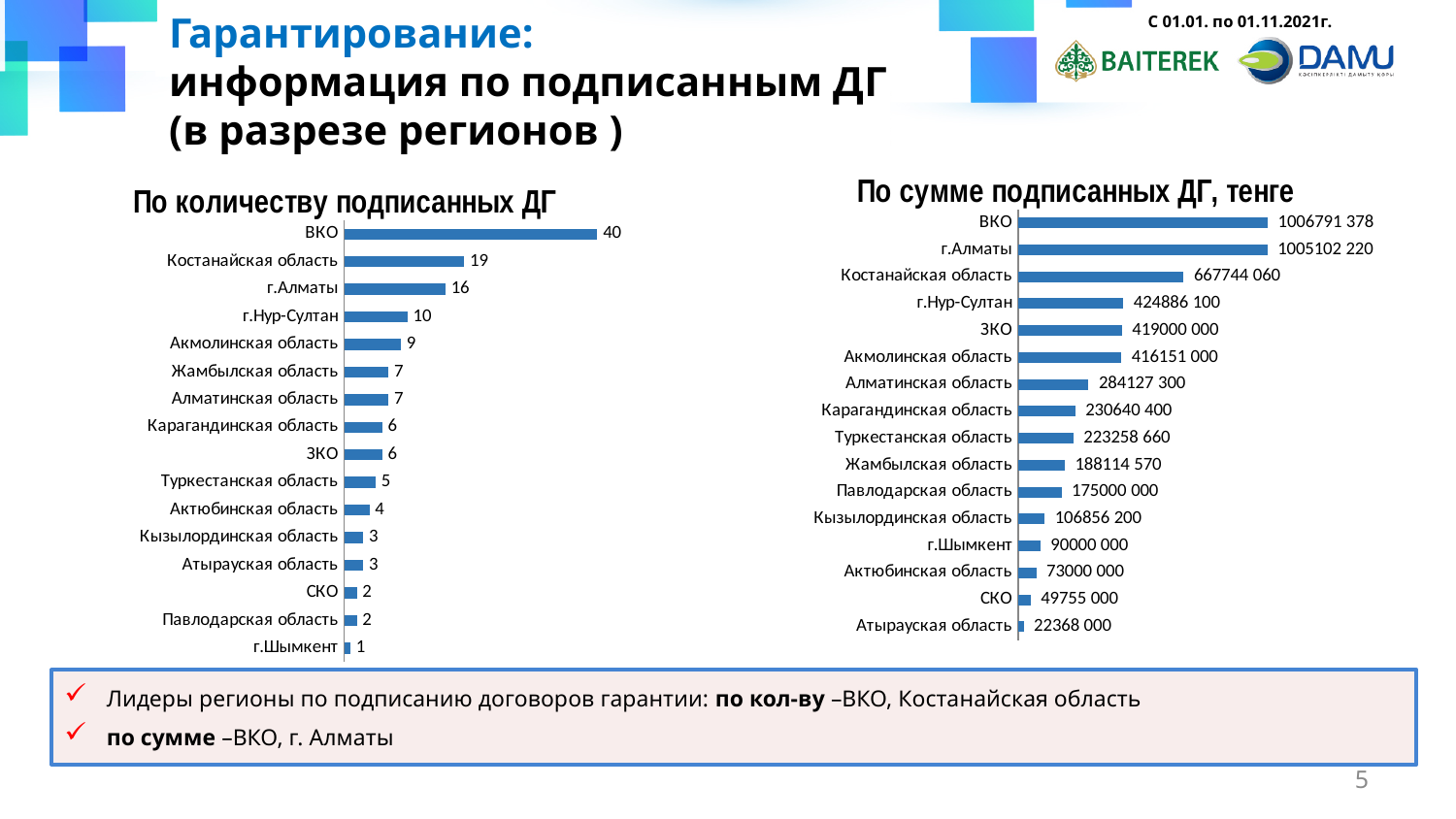
In the chart 'По сумме подписанных ДГ, тенге', which region has the lowest value? Атырауская область In the chart 'По количеству подписанных ДГ', what is the value for Актюбинская область? 4 In the chart 'По сумме подписанных ДГ, тенге', which is larger: Костанайская область or г.Нур-Султан? Костанайская область In the chart 'По количеству подписанных ДГ', what is the difference between ВКО and г.Алматы? 24 In the chart 'По количеству подписанных ДГ', which category has the lowest value? г.Шымкент In the chart 'По количеству подписанных ДГ', how many categories are shown? 16 In the chart 'По сумме подписанных ДГ, тенге', what is the value for г.Нур-Султан? 424886 100 In the chart 'По сумме подписанных ДГ, тенге', what is the value for СКО? 49755 000 In the chart 'По количеству подписанных ДГ', which region has the highest value? ВКО In the chart 'По сумме подписанных ДГ, тенге', what is the difference between г.Шымкент and Актюбинская область? 17000 000 What type of chart is 'По сумме подписанных ДГ, тенге'? Bar chart In the chart 'По количеству подписанных ДГ', what is the value for Костанайская область? 19